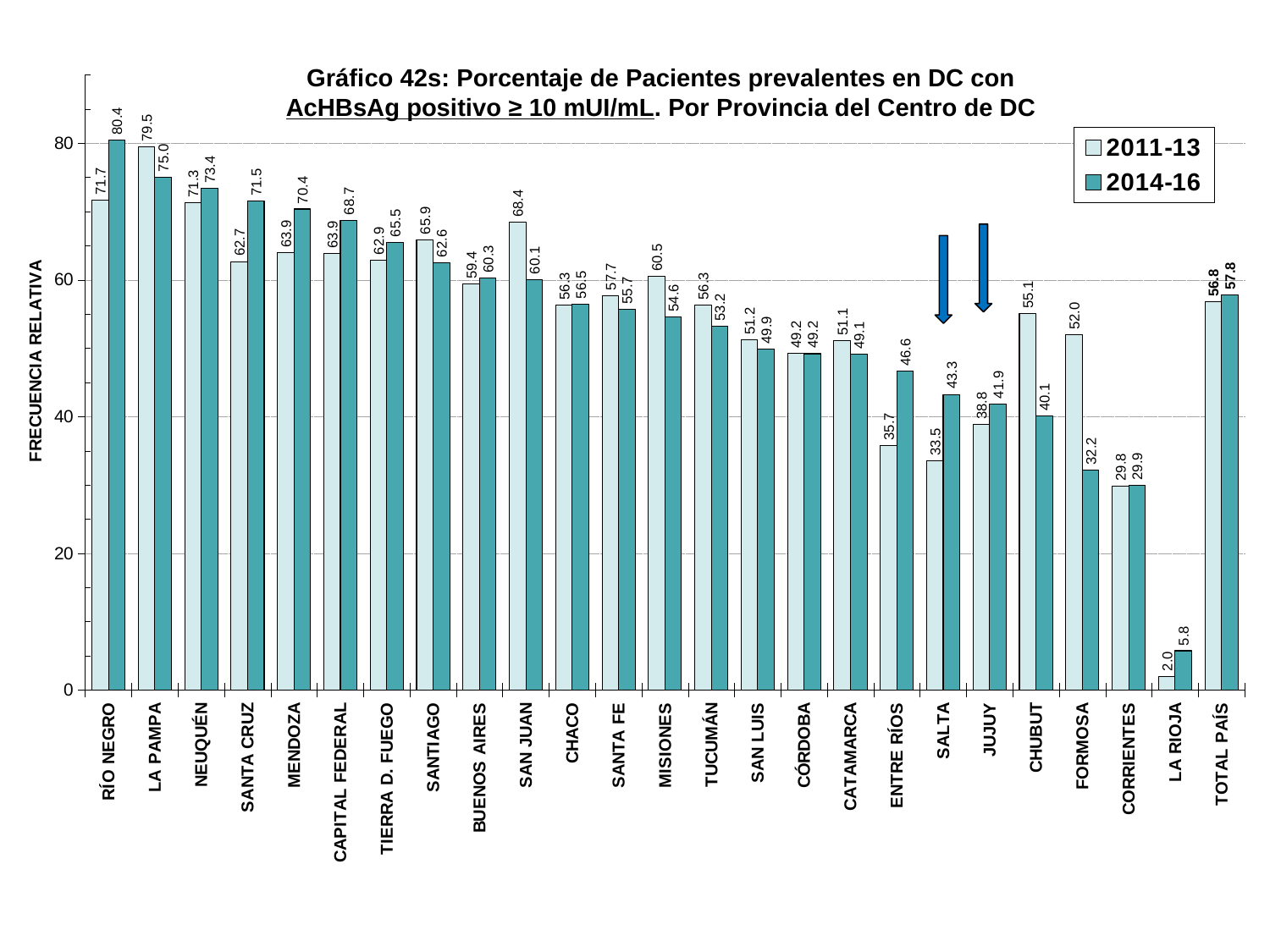
Which province has the highest 2011-13 value? LA PAMPA What is the 2014-16 value for TOTAL PAÍS? 57.8 What is the 2014-16 value for RÍO NEGRO? 80.4 Which province has the highest 2014-16 value? RÍO NEGRO How many series does the legend list? 2 Which province has the lowest 2011-13 value? LA RIOJA What is the 2011-13 value for SALTA? 33.5 How many provinces/categories are shown on the x axis? 25 What is the difference between the 2014-16 and 2011-13 values for FORMOSA? 19.8 What is the label of the y axis? FRECUENCIA RELATIVA Which is larger for CHUBUT, the 2011-13 value or the 2014-16 value? 2011-13 What kind of chart is this? Bar chart